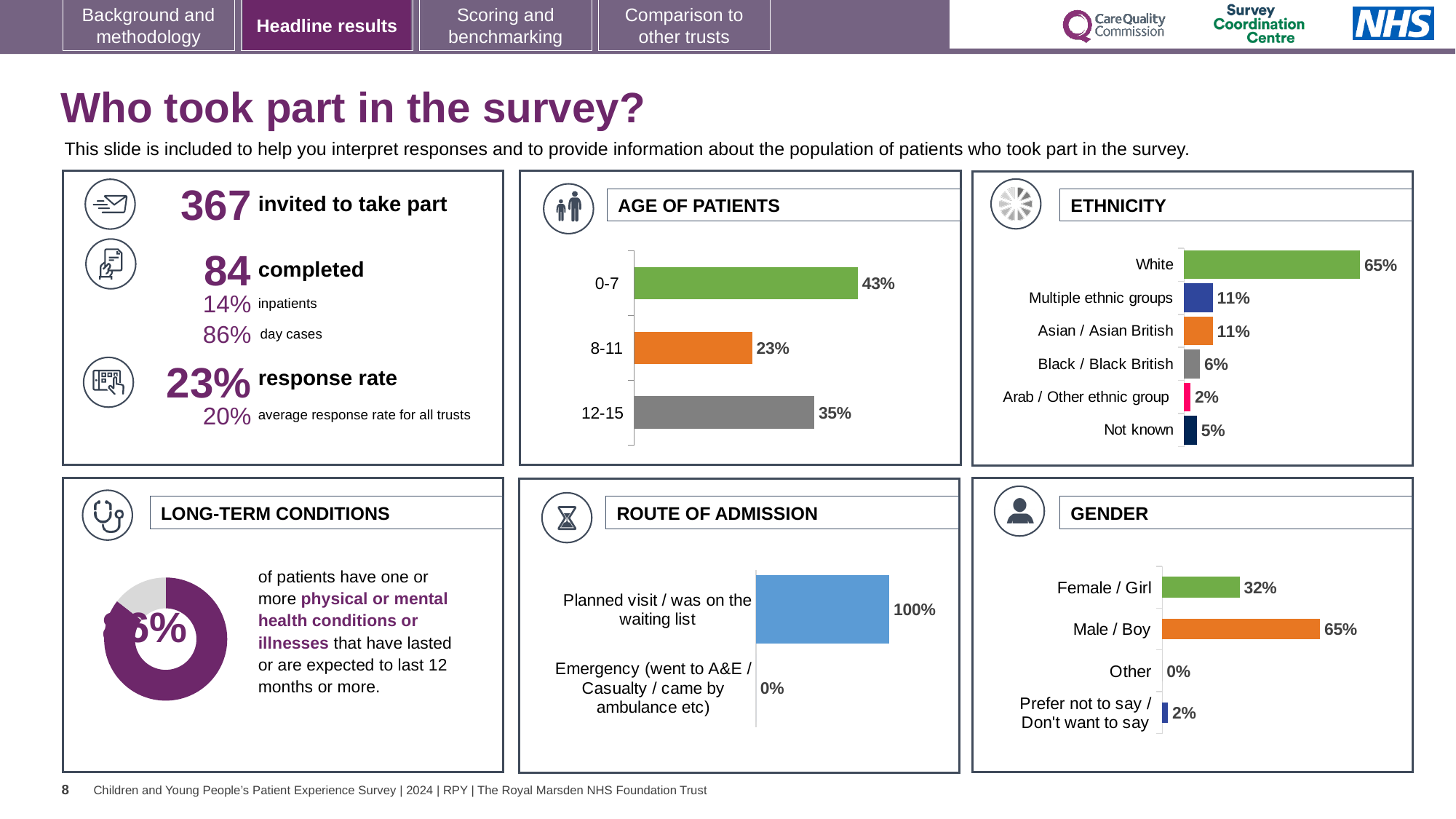
What type of chart is used in the AGE OF PATIENTS panel? Bar chart In the ETHNICITY chart, which ethnic group has the lowest percentage? Arab / Other ethnic group In the AGE OF PATIENTS chart, what percentage of patients were aged 0-7? 43% In the GENDER chart, what is the difference between the Male / Boy and Female / Girl percentages? 33% In the AGE OF PATIENTS chart, what is the difference between the 0-7 and 12-15 percentages? 8% In the GENDER chart, what percentage of patients were Male / Boy? 65% In the ETHNICITY chart, which is larger: Black / Black British or Not known? Black / Black British How many ethnic group categories are shown in the ETHNICITY chart? 6 In the ROUTE OF ADMISSION chart, what percentage of patients had a planned visit / were on the waiting list? 100% In the ETHNICITY chart, what percentage of patients were White? 65% In the AGE OF PATIENTS chart, which age group has the lowest percentage? 8-11 How many categories are shown in the GENDER chart? 4